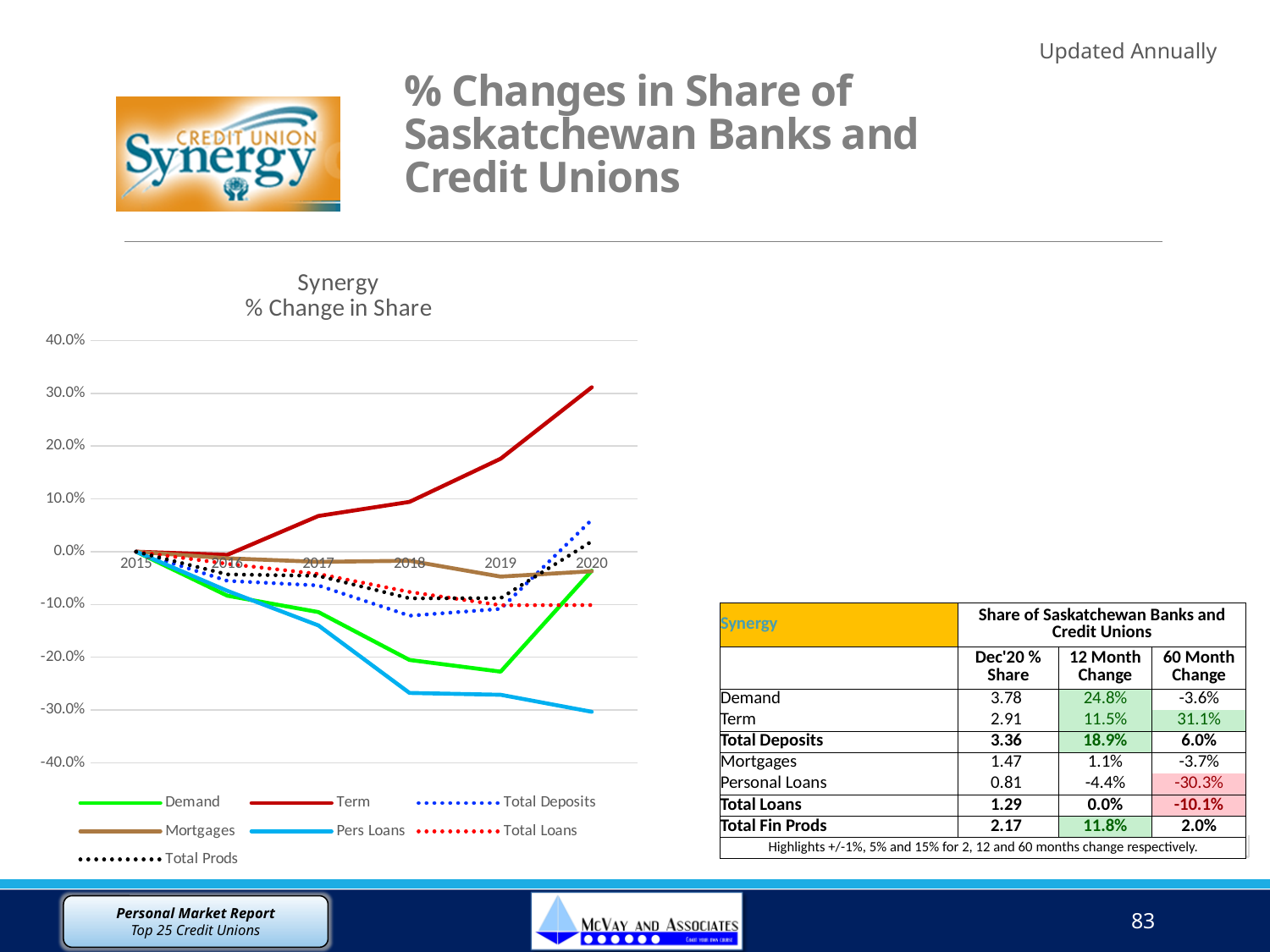
In 2020, which is higher: Demand or Pers Loans? Demand What is the value for Term in 2015? 0.0% Does the Term series rise or fall from 2015 to 2020? rises Is the value for Term in 2020 greater or less than 20.0%? greater What is the title of the chart? Synergy % Change in Share Is the value for Pers Loans in 2020 greater or less than -20.0%? less Is the value for Demand in 2019 greater or less than -20.0%? less Which series has the highest value in 2020? Term What kind of chart is shown on the slide? line chart How many years are shown along the x axis of the chart? 6 How many series does the chart legend list? 7 Which series has the lowest value in 2020? Pers Loans